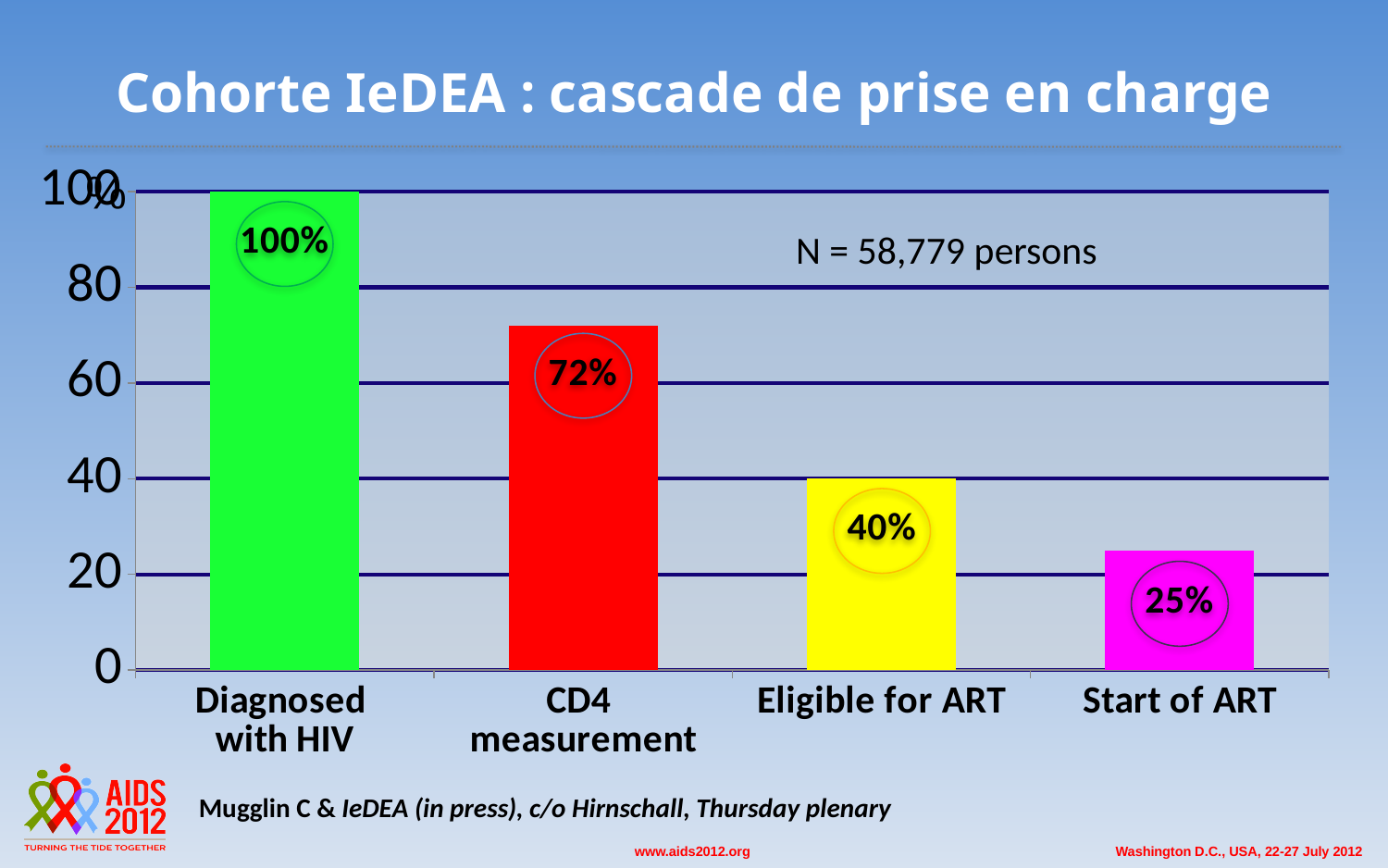
What is the value for Eligible for ART? 40% How many categories are shown on the x axis? 4 What is the difference between the values for CD4 measurement and Eligible for ART? 32% What is the value for CD4 measurement? 72% Which category has the lowest value? Start of ART What kind of chart is shown on the slide? Bar chart Which is larger, the value for CD4 measurement or the value for Start of ART? CD4 measurement What is the difference between the values for Eligible for ART and Start of ART? 15% What is the value for Start of ART? 25% Do the values rise or fall from left to right along the x axis? Fall What is the value for Diagnosed with HIV? 100% Which category has the highest value? Diagnosed with HIV